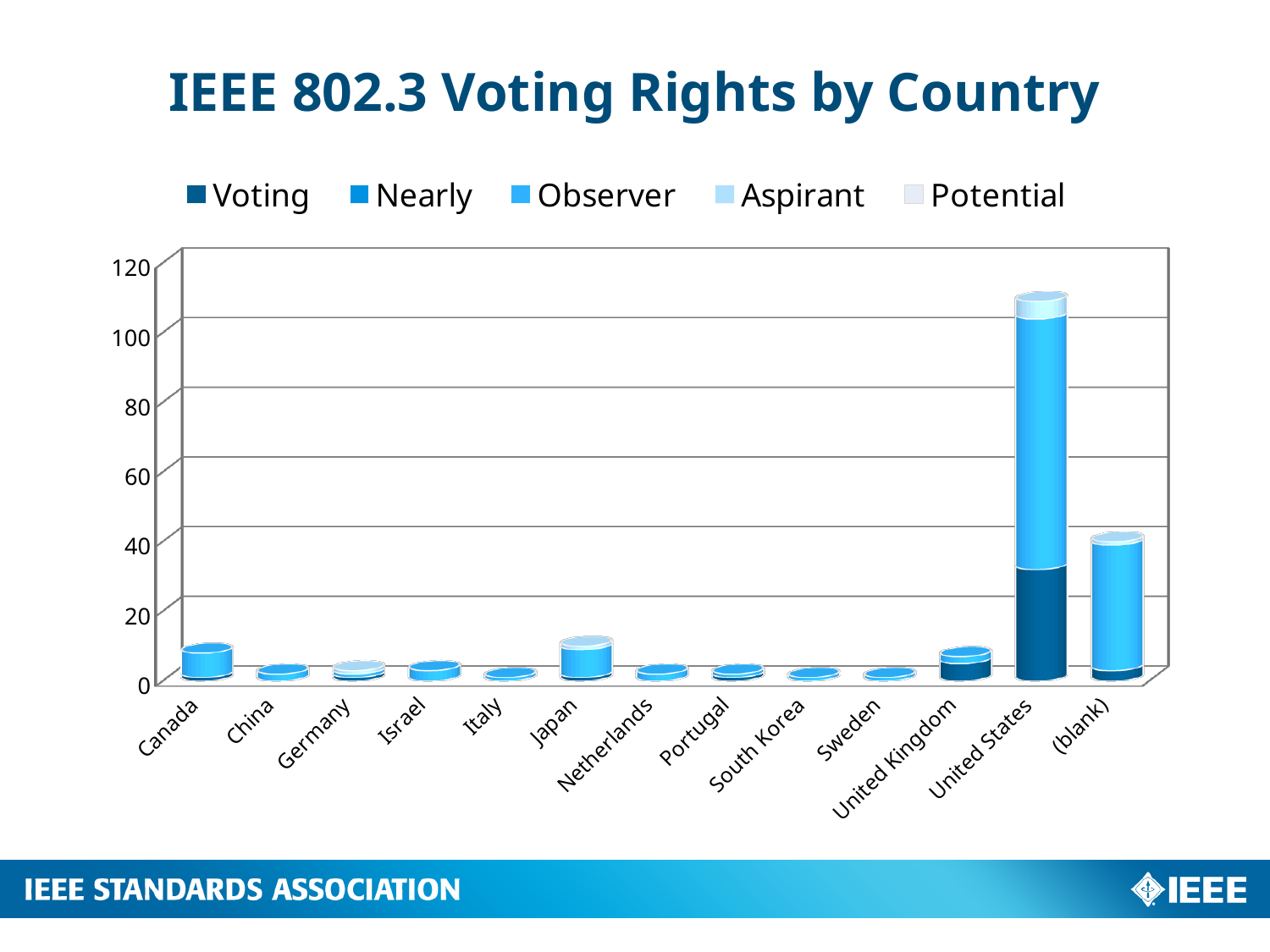
Is the total bar height for Japan greater or less than 20? less Is the total bar height for United States greater or less than 100? greater How many countries (categories) are shown on the x axis? 13 What is the title of the chart? IEEE 802.3 Voting Rights by Country Which country has the tallest bar? United States Is the total bar height for Canada greater or less than 20? less How many series does the legend list? 5 Which legend entry is shown in the darkest blue? Voting Which bar is taller, United States or (blank)? United States What kind of chart is shown on the slide? Stacked bar chart Which bar is taller, Japan or China? Japan